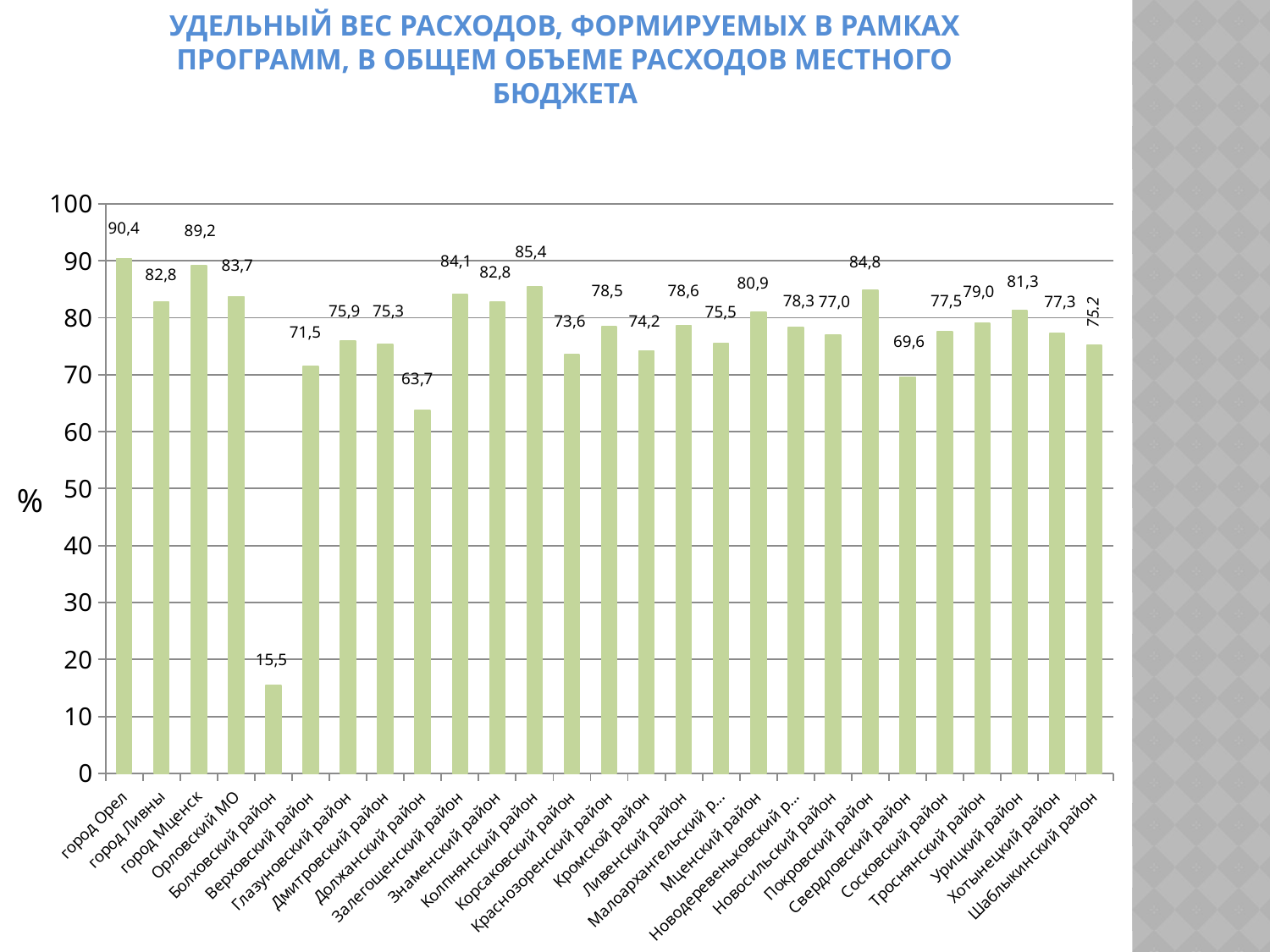
Is the value for Покровский район greater or less than 80? greater What is the value for Болховский район? 15,5 What is the value for город Орел? 90,4 What kind of chart is shown on the slide? bar chart What is the difference between the values for город Орел and город Мценск? 1,2 What unit label is shown on the vertical axis? % What is the value for Колпнянский район? 85,4 Which category has the highest value? город Орел Which category has the lowest value? Болховский район What is the value for Свердловский район? 69,6 Which is larger, the value for Должанский район or the value for Верховский район? Верховский район How many categories are shown on the x axis? 27